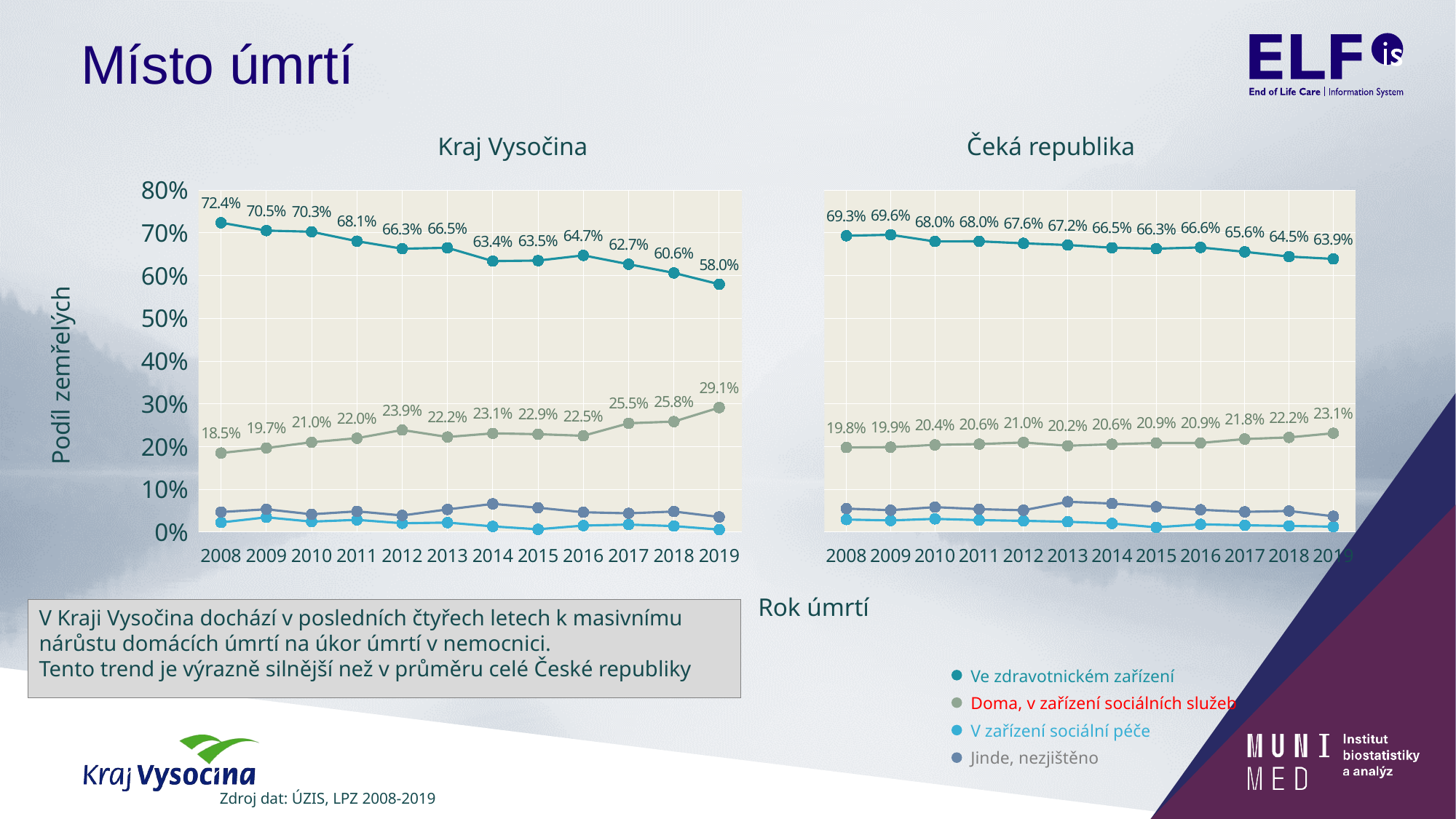
Which is larger: the 2019 'Doma, v zařízení sociálních služeb' value in the Kraj Vysočina chart or in the Čeká republika chart? Kraj Vysočina In the Kraj Vysočina chart, what is the value for 'Ve zdravotnickém zařízení' in 2019? 58.0% How many series does the legend list? 4 In the Čeká republika chart, what is the value for 'Doma, v zařízení sociálních služeb' in 2019? 23.1% In the Čeká republika chart, what is the value for 'Ve zdravotnickém zařízení' in 2012? 67.6% In the Kraj Vysočina chart, what is the difference between the 'Ve zdravotnickém zařízení' values for 2008 and 2019? 14.4% In the Kraj Vysočina chart, in which year is 'Ve zdravotnickém zařízení' highest? 2008 In the Čeká republika chart, what is the difference between the 'Doma, v zařízení sociálních služeb' values for 2019 and 2008? 3.3% In the Kraj Vysočina chart, does 'Ve zdravotnickém zařízení' rise or fall from 2008 to 2019? fall In the Kraj Vysočina chart, what is the value for 'Doma, v zařízení sociálních služeb' in 2008? 18.5% How many years are plotted on the x axis of the Čeká republika chart? 12 In the Kraj Vysočina chart, in which year is 'Doma, v zařízení sociálních služeb' lowest? 2008